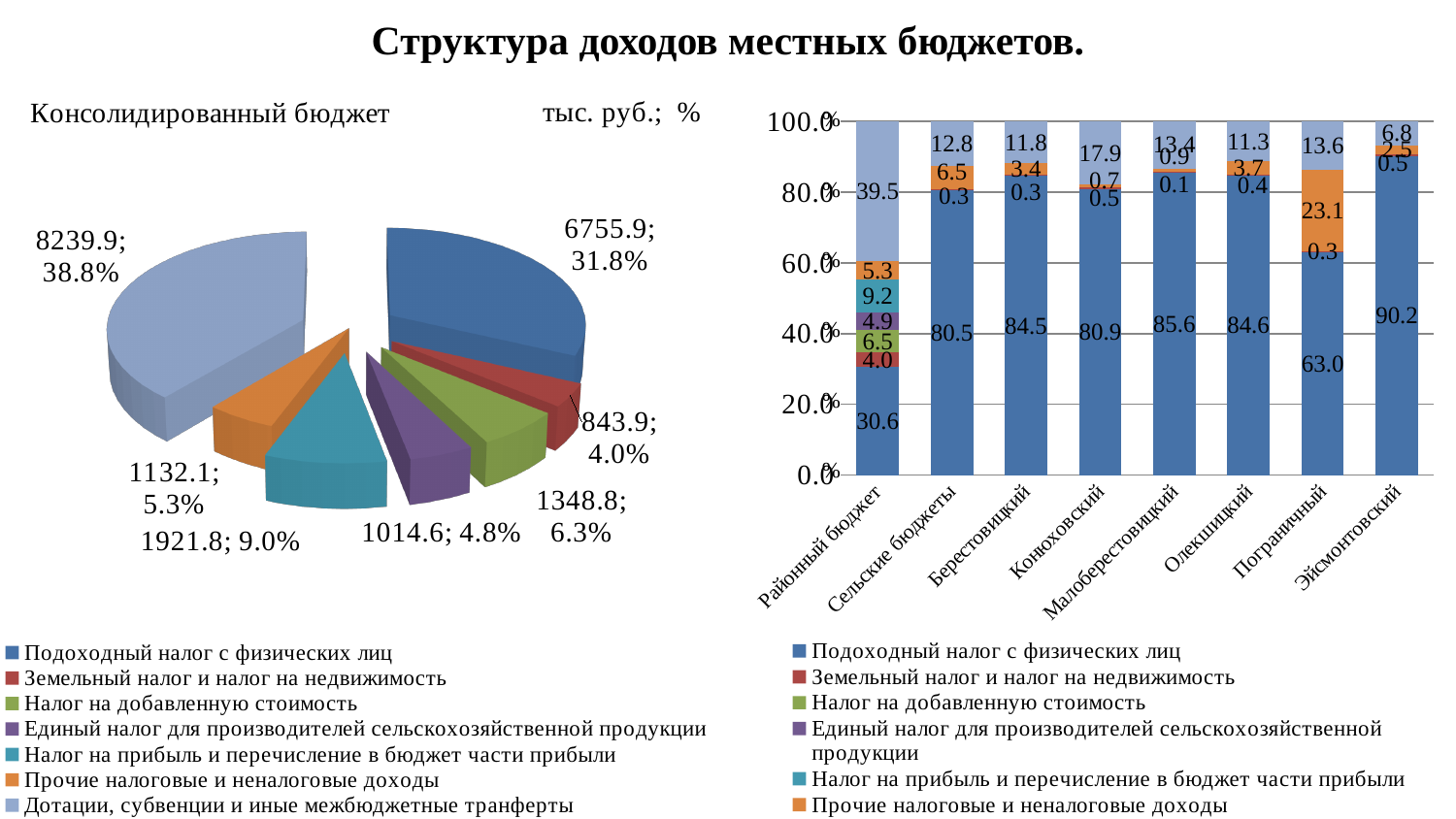
On the pie chart (Консолидированный бюджет), which category has the largest slice? Дотации, субвенции и иные межбюджетные трансферты What kind of chart is the chart on the right side of the slide? Stacked bar chart On the stacked bar chart on the right, which category has the lowest value for Подоходный налог с физических лиц? Районный бюджет On the pie chart (Консолидированный бюджет), what share does Налог на прибыль и перечисление в бюджет части прибыли have? 9.0% On the pie chart (Консолидированный бюджет), what value and share are shown for Подоходный налог с физических лиц? 6755.9; 31.8% On the stacked bar chart on the right, what is the difference between the Подоходный налог с физических лиц values for Эйсмонтовский (90.2) and Пограничный (63.0)? 27.2 How many categories are shown on the x axis of the stacked bar chart on the right? 8 How many entries does the legend of the pie chart (Консолидированный бюджет) list? 7 On the pie chart (Консолидированный бюджет), which category has the smallest slice? Земельный налог и налог на недвижимость On the stacked bar chart on the right, what is the value of Подоходный налог с физических лиц for Эйсмонтовский? 90.2 On the stacked bar chart on the right, what is the value of Прочие налоговые и неналоговые доходы for Пограничный? 23.1 On the pie chart (Консолидированный бюджет), what is the difference between the value for Дотации, субвенции и иные межбюджетные трансферты (8239.9) and the value for Подоходный налог с физических лиц (6755.9)? 1484.0